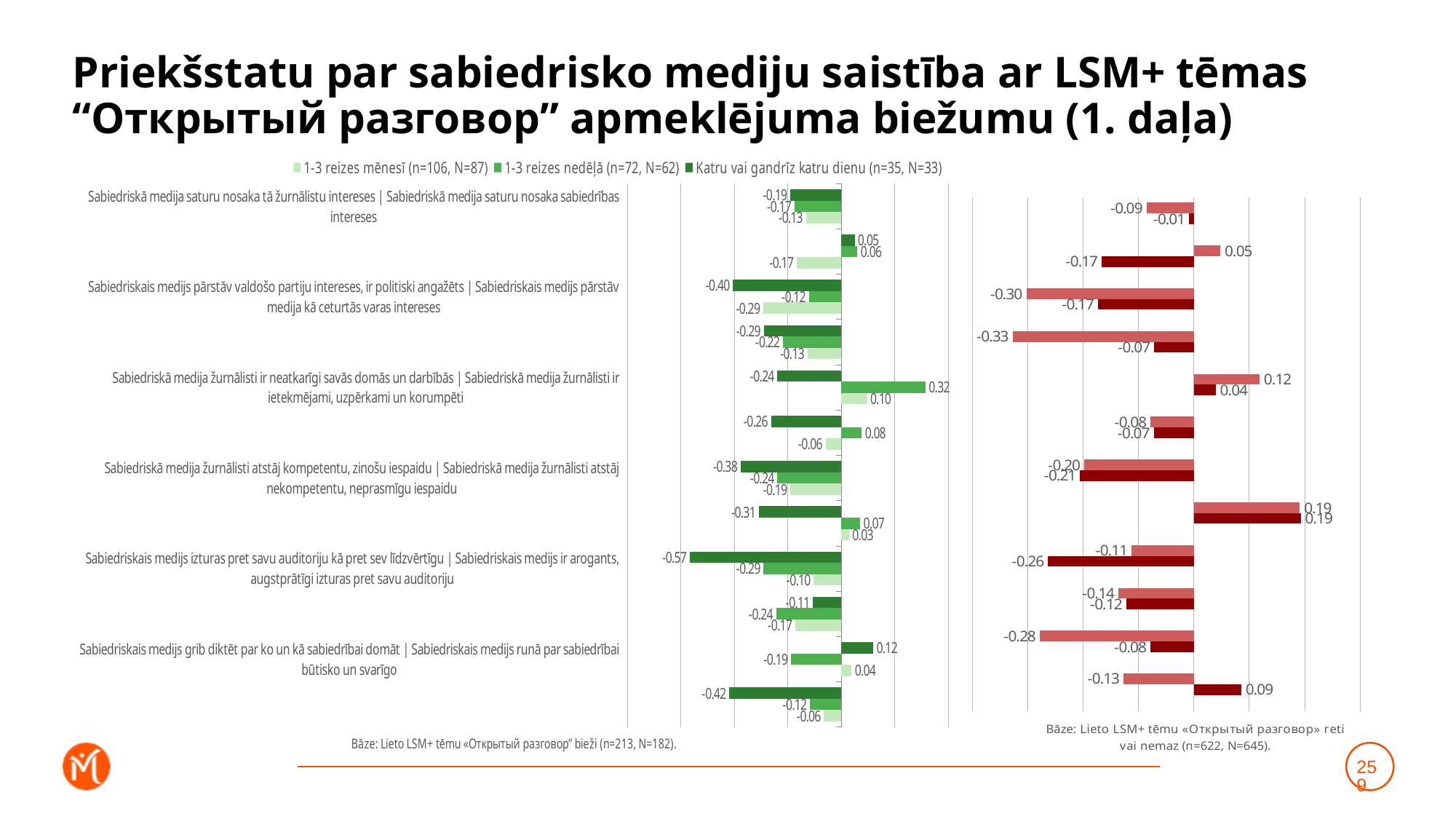
What base note is printed below the left (green) chart? Bāze: Lieto LSM+ tēmu «Открытый разговор» bieži (n=213, N=182). In the left (green) chart, which series does the bar with the value -0.57 belong to? Katru vai gandrīz katru dienu (n=35, N=33) In the right (red) chart, what is the lowest labeled value? -0.33 How many series does the legend of the left (green) chart list? 3 What kind of chart is shown on the left side of the slide? bar chart In the left (green) chart, what is the lowest labeled value? -0.57 In the left (green) chart, what is the highest labeled value? 0.32 What is the legend entry for the lightest green series in the left chart? 1-3 reizes mēnesī (n=106, N=87) In the right (red) chart, what is the highest labeled value? 0.19 In the left (green) chart, what is the difference between the highest labeled value (0.32) and the lowest labeled value (-0.57)? 0.89 Which is larger: the highest labeled value in the left (green) chart or the highest labeled value in the right (red) chart? the left (green) chart